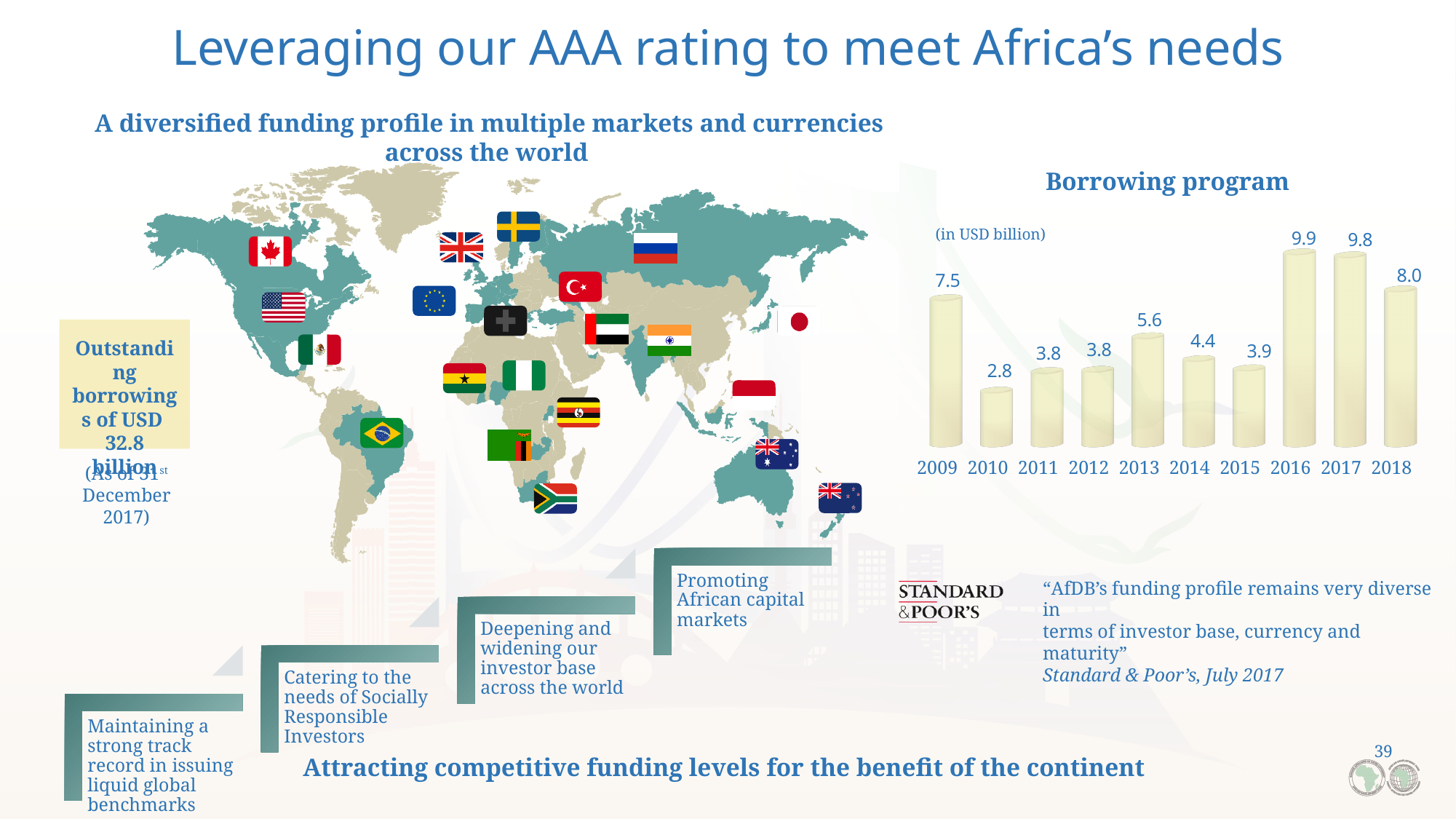
What is the difference between the borrowing program values for 2013 and 2014? 1.2 What is the value of the borrowing program for 2018? 8.0 What is the value of the borrowing program for 2009? 7.5 What is the value of the borrowing program for 2016? 9.9 What is the difference between the borrowing program values for 2016 and 2010? 7.1 Which year has the lowest value in the Borrowing program chart? 2010 Which year has the highest value in the Borrowing program chart? 2016 In what unit are the values of the Borrowing program chart expressed? USD billion Which year has a larger borrowing program value, 2009 or 2018? 2018 How many years are shown in the Borrowing program chart? 10 Do the borrowing program values rise or fall from 2015 to 2016? rise What kind of chart is the Borrowing program chart? bar chart